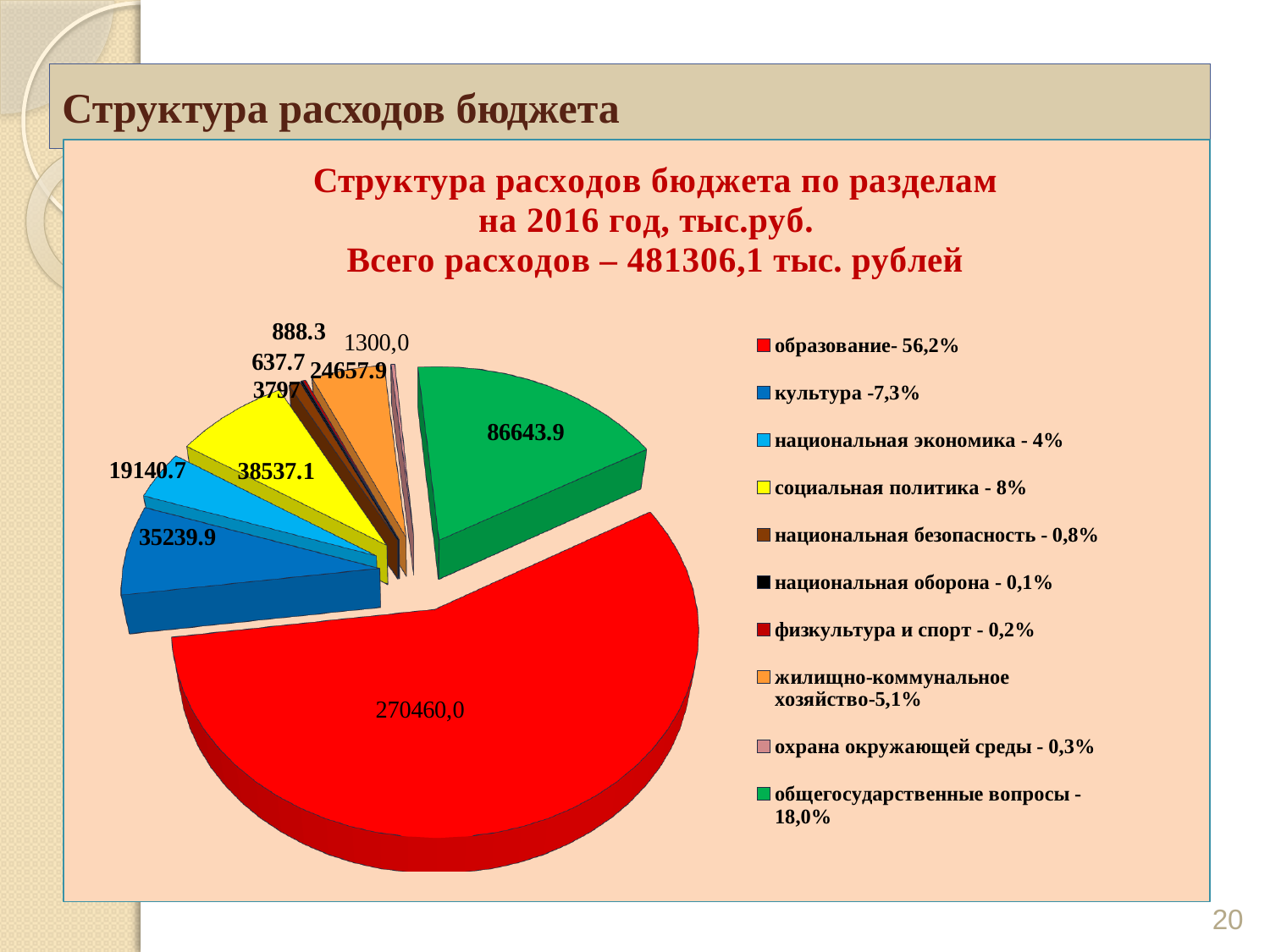
Which category has the smallest share according to the legend? национальная оборона What type of chart is shown on the slide? pie chart Which is larger, the value for социальная политика or the value for культура? социальная политика Which category has the largest slice of the pie? образование What share of the pie does образование represent according to the legend? 56,2% What is the difference between the value for общегосударственные вопросы and the value for культура? 51404.0 What is the value for культура? 35239.9 What is the value for жилищно-коммунальное хозяйство? 24657.9 How many categories does the legend list? 10 What is the value for социальная политика? 38537.1 What is the value for образование? 270460,0 What is the value for общегосударственные вопросы? 86643.9